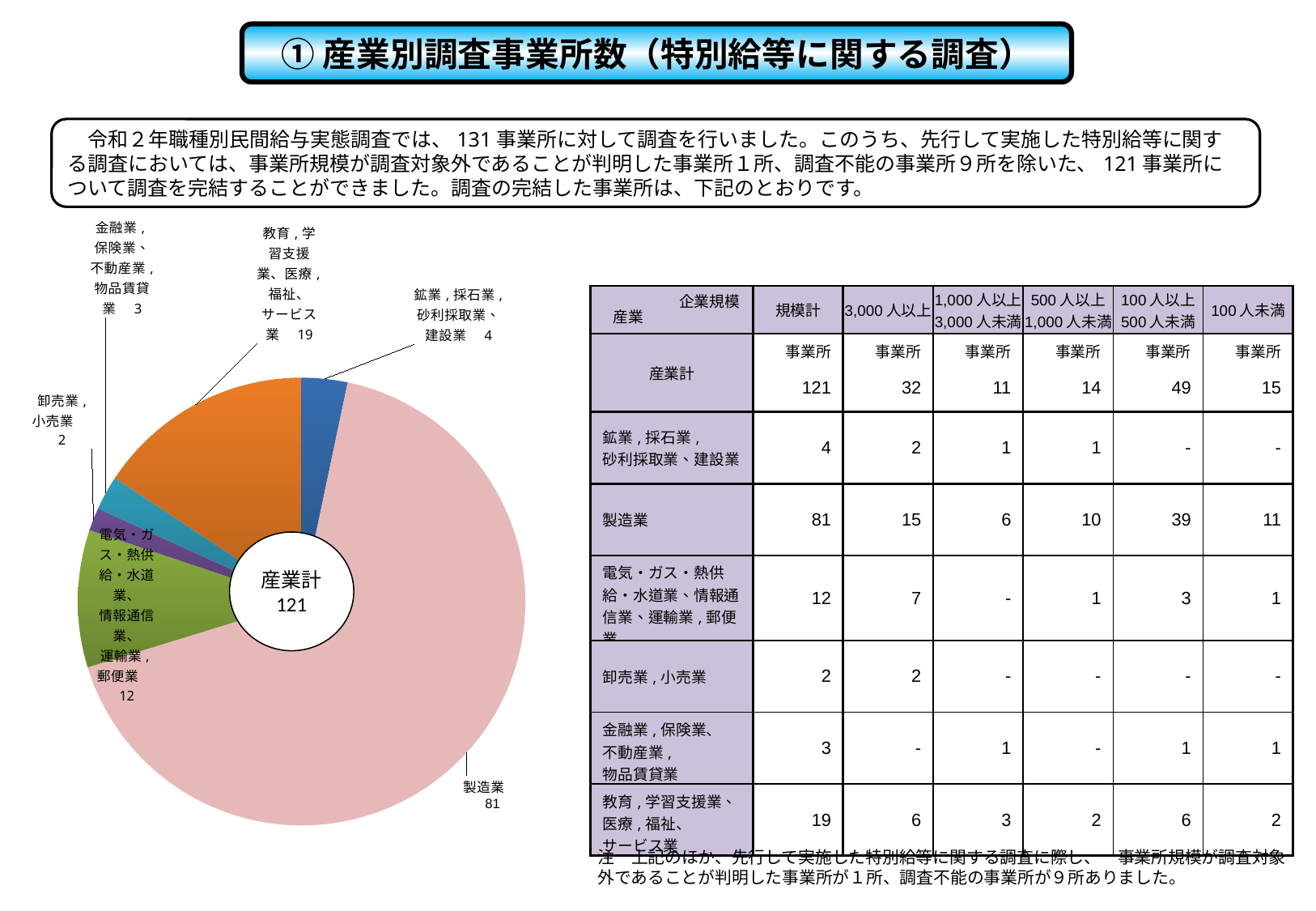
What total is shown in the centre of the pie chart? 産業計 121 Which category has the largest slice in the pie chart? 製造業 Which category has the smallest slice in the pie chart? 卸売業,小売業 What kind of chart is shown on the left of the slide? Pie chart (doughnut) In the pie chart, which is larger: 電気・ガス・熱供給・水道業、情報通信業、運輸業,郵便業 or 鉱業,採石業,砂利採取業、建設業? 電気・ガス・熱供給・水道業、情報通信業、運輸業,郵便業 In the pie chart, what is the value for 教育,学習支援業、医療,福祉、サービス業? 19 In the pie chart, what is the value for 金融業,保険業、不動産業,物品賃貸業? 3 How many categories (slices) does the pie chart have? 6 In the pie chart, what is the difference between the values for 製造業 and 教育,学習支援業、医療,福祉、サービス業? 62 In the pie chart, what is the value for 鉱業,採石業,砂利採取業、建設業? 4 In the pie chart, what is the value for 製造業? 81 In the pie chart, what is the value for 卸売業,小売業? 2